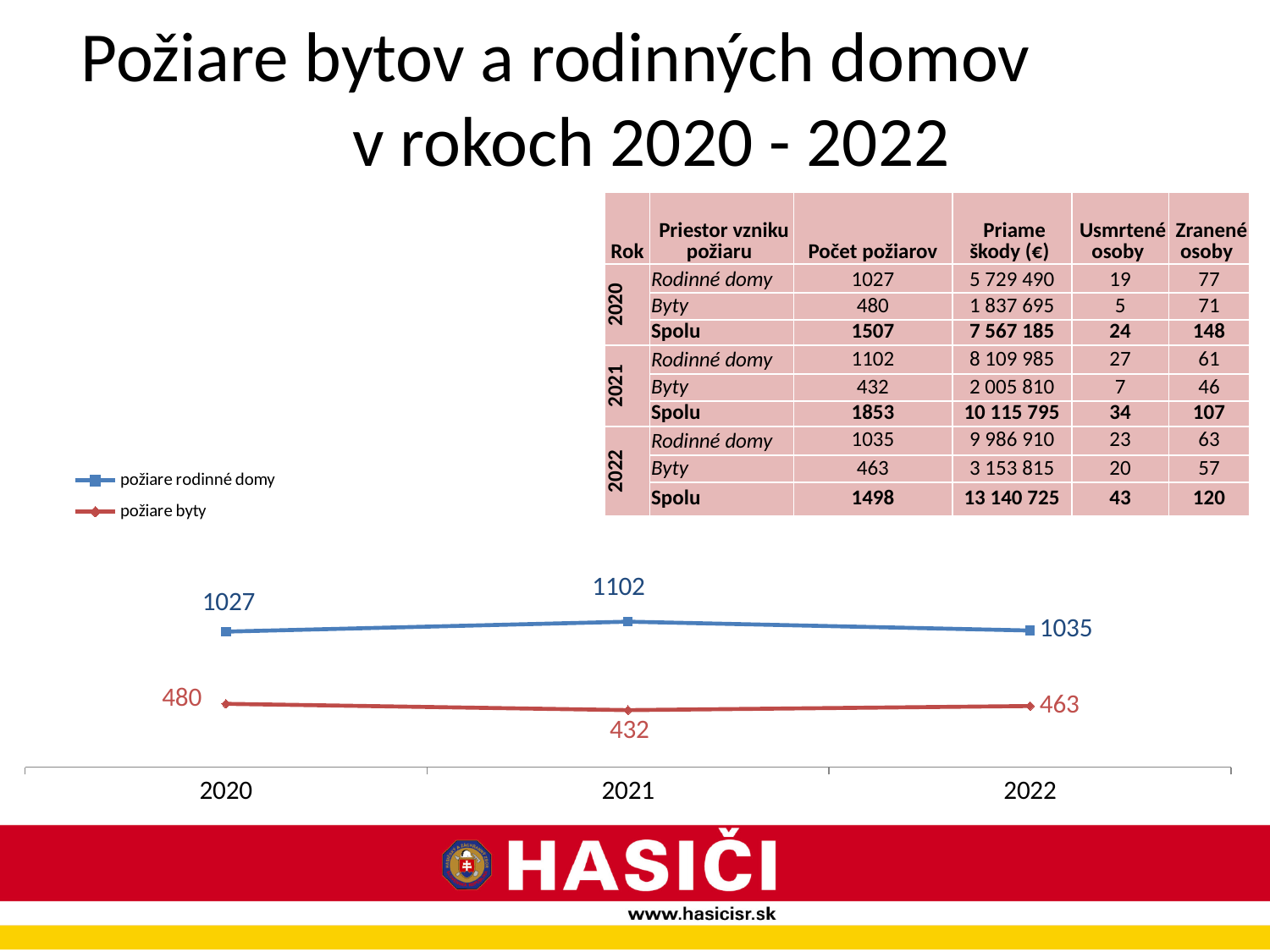
In which year is požiare rodinné domy highest? 2021 What colour is the line for požiare byty? red How many series does the chart legend list? 2 What is the difference between požiare rodinné domy and požiare byty in 2022? 572 What is the value for požiare rodinné domy in 2021? 1102 What is the value for požiare byty in 2022? 463 What is the value for požiare byty in 2020? 480 How many years are shown on the x axis of the chart? 3 Which is larger in 2020: požiare rodinné domy or požiare byty? požiare rodinné domy Does požiare rodinné domy rise or fall from 2021 to 2022? fall What kind of chart is shown on the slide? line chart In which year is požiare byty lowest? 2021